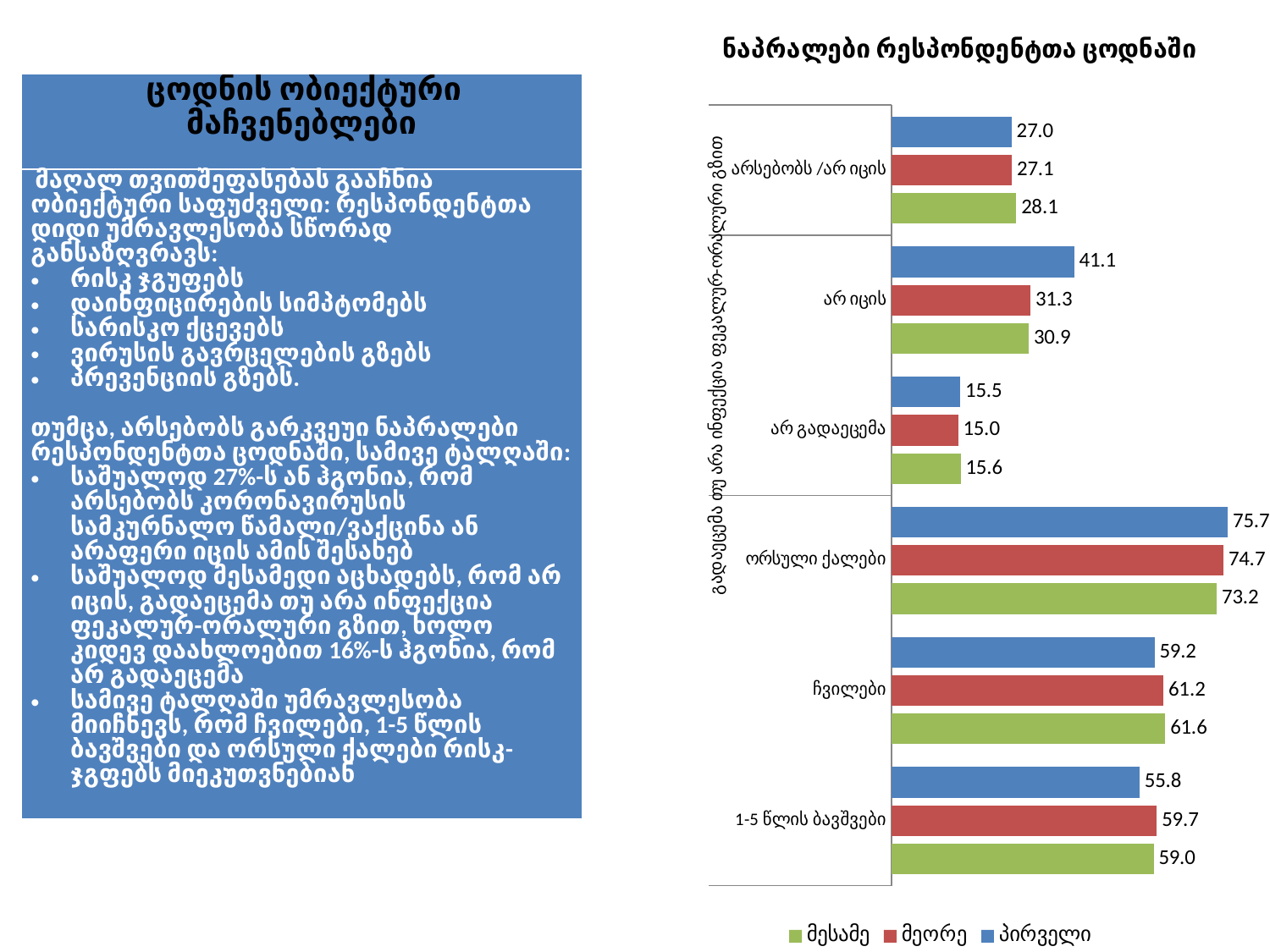
What is the difference between the პირველი and მეორე values for the category არ იცის? 9.8 What is the value of the მეორე series for the category 1-5 წლის ბავშვები? 59.7 What is the title of the chart? ნაპრალები რესპონდენტთა ცოდნაში How many series does the chart legend list? 3 How many categories are shown on the chart? 6 Which category has the highest value in the პირველი series? ორსული ქალები Which category has the lowest value in the მეორე series? არ გადაეცემა Which colour represents the პირველი series in the chart? blue What is the value of the მესამე series for the category ორსული ქალები? 73.2 For the category ჩვილები, which series has the larger value: პირველი or მესამე? მესამე What is the value of the პირველი series for the category არ იცის? 41.1 What type of chart is shown on the slide? bar chart